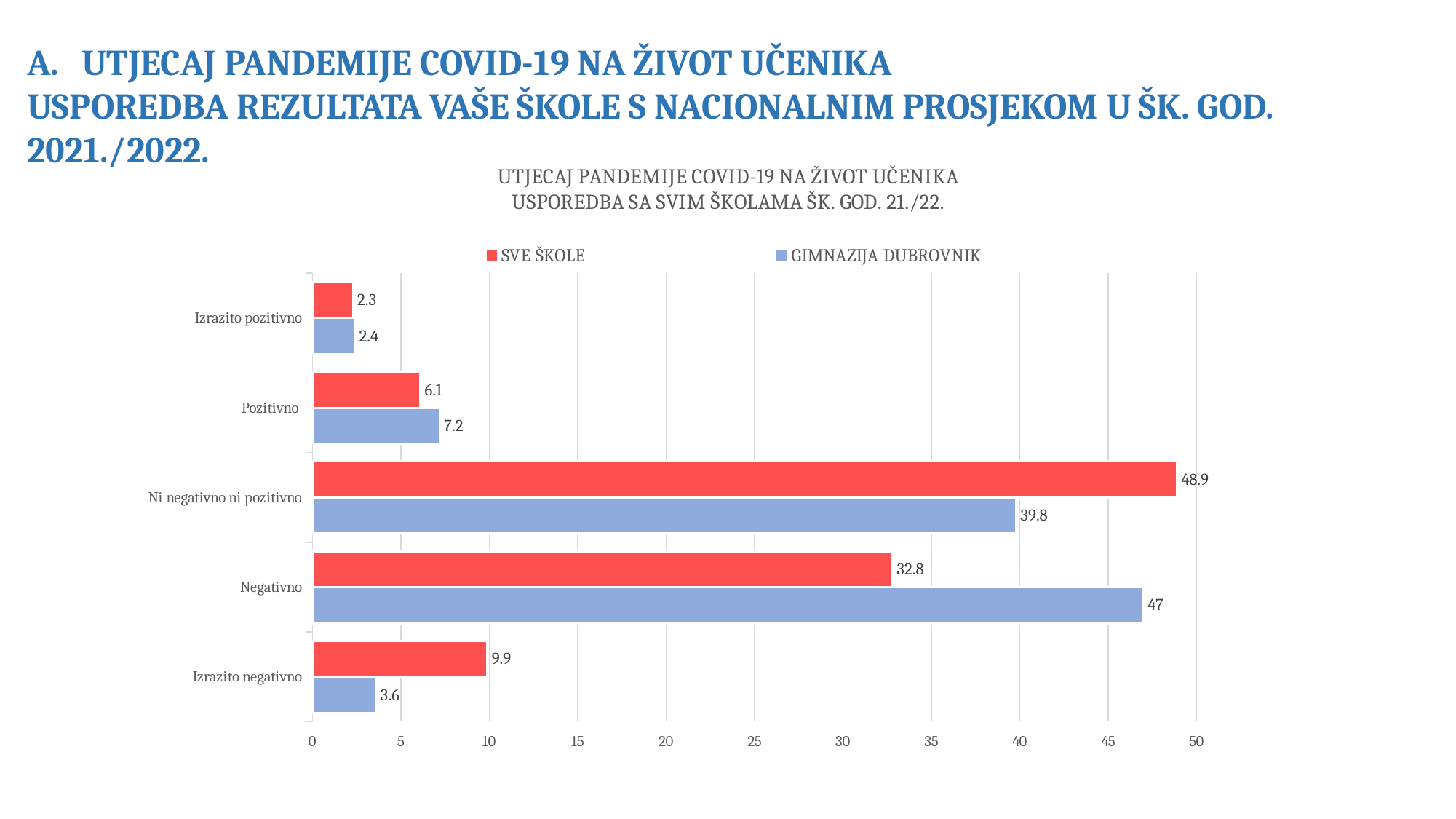
Which category has the highest value for SVE ŠKOLE? Ni negativno ni pozitivno Which colour represents the SVE ŠKOLE series? Red Which category has the lowest value for GIMNAZIJA DUBROVNIK? Izrazito pozitivno What is the value for GIMNAZIJA DUBROVNIK in the 'Izrazito negativno' category? 3.6 In the 'Izrazito negativno' category, which series has the larger value, SVE ŠKOLE or GIMNAZIJA DUBROVNIK? SVE ŠKOLE How many categories are shown on the chart? 5 What kind of chart is shown on the slide? Bar chart What is the difference between the SVE ŠKOLE and GIMNAZIJA DUBROVNIK values in the 'Negativno' category? 14.2 What is the value for GIMNAZIJA DUBROVNIK in the 'Negativno' category? 47 What is the value for SVE ŠKOLE in the 'Ni negativno ni pozitivno' category? 48.9 How many series does the legend list? 2 Is the value for GIMNAZIJA DUBROVNIK in the 'Ni negativno ni pozitivno' category greater or less than 45? less